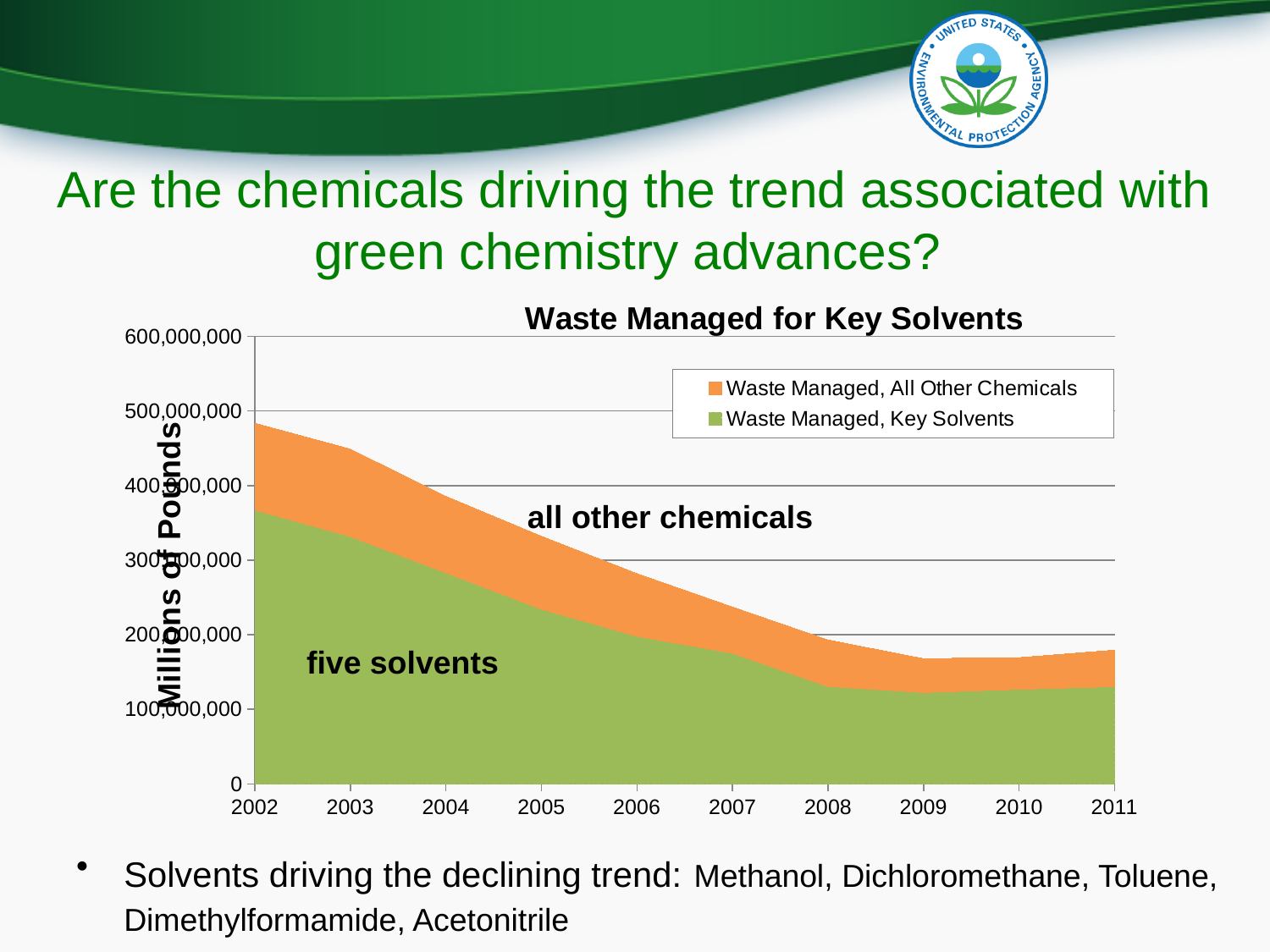
Is the total waste managed (both series combined) in 2002 greater or less than 400,000,000? greater Is the value for Waste Managed, Key Solvents in 2002 greater or less than 300,000,000? greater Is the value for Waste Managed, Key Solvents in 2011 greater or less than 200,000,000? less What is the label of the y axis? Millions of Pounds How many series does the chart legend list? 2 What type of chart is shown on the slide? Stacked area chart Which year has the larger value for Waste Managed, Key Solvents: 2002 or 2011? 2002 Does the waste managed for key solvents rise or fall from 2002 to 2011? Fall How many years are shown along the x axis of the chart? 10 What is the title of the chart? Waste Managed for Key Solvents In which year is the waste managed for key solvents highest? 2002